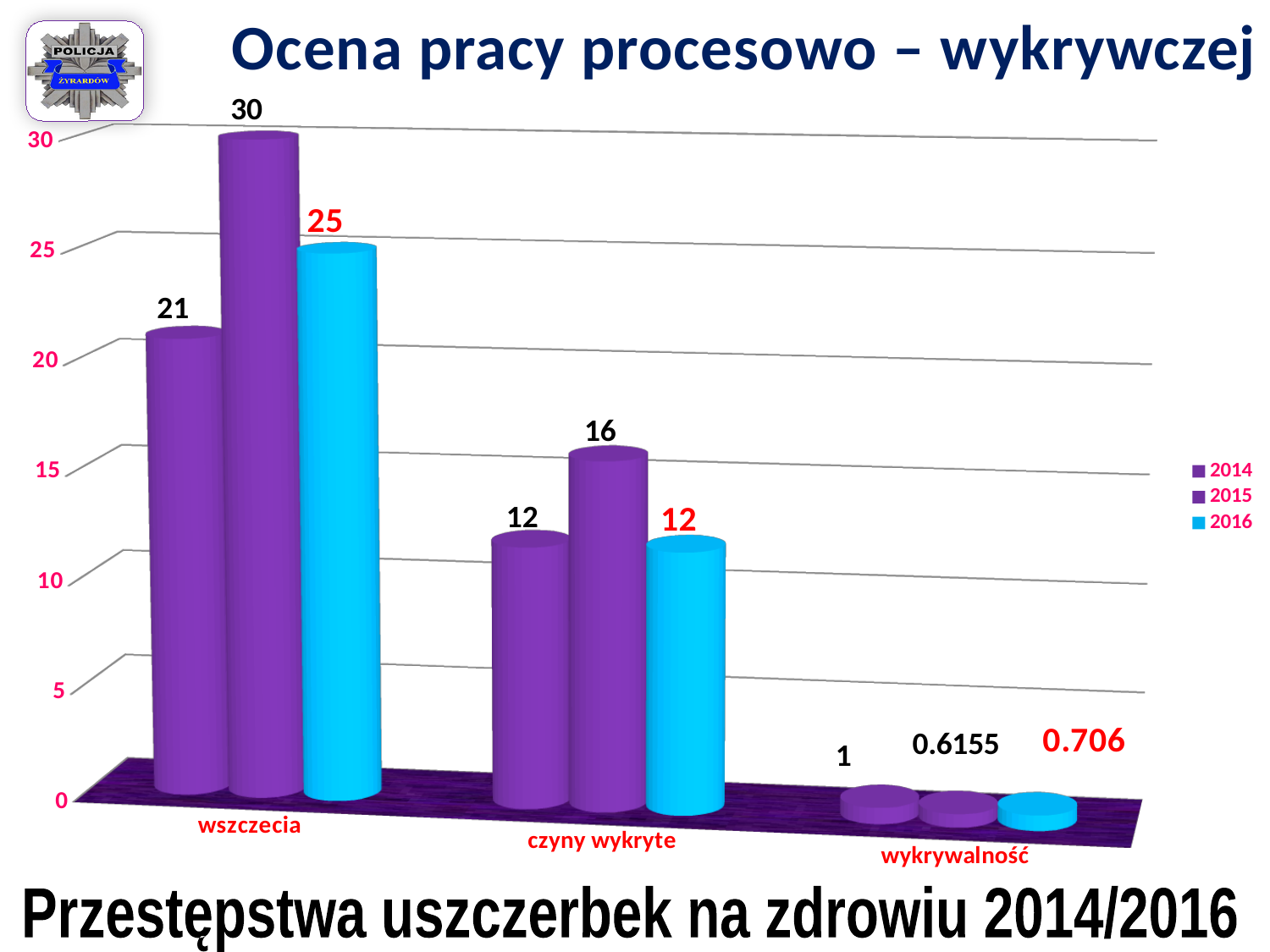
How many categories are shown on the x axis? 3 What is the title of the chart? Ocena pracy procesowo – wykrywczej Which year has the lowest value in the wykrywalność category? 2015 What is the value for 2016 in the czyny wykryte category? 12 What is the value for 2014 in the wykrywalność category? 1 Which year has the highest value in the wszczecia category? 2015 How many series does the legend list? 3 Which is larger: the 2016 value for wszczecia or the 2015 value for czyny wykryte? 2016 value for wszczecia What is the difference between the 2015 and 2014 values in the wszczecia category? 9 What is the value for 2015 in the wykrywalność category? 0.6155 What kind of chart is shown on the slide? bar chart What is the value for 2015 in the wszczecia category? 30